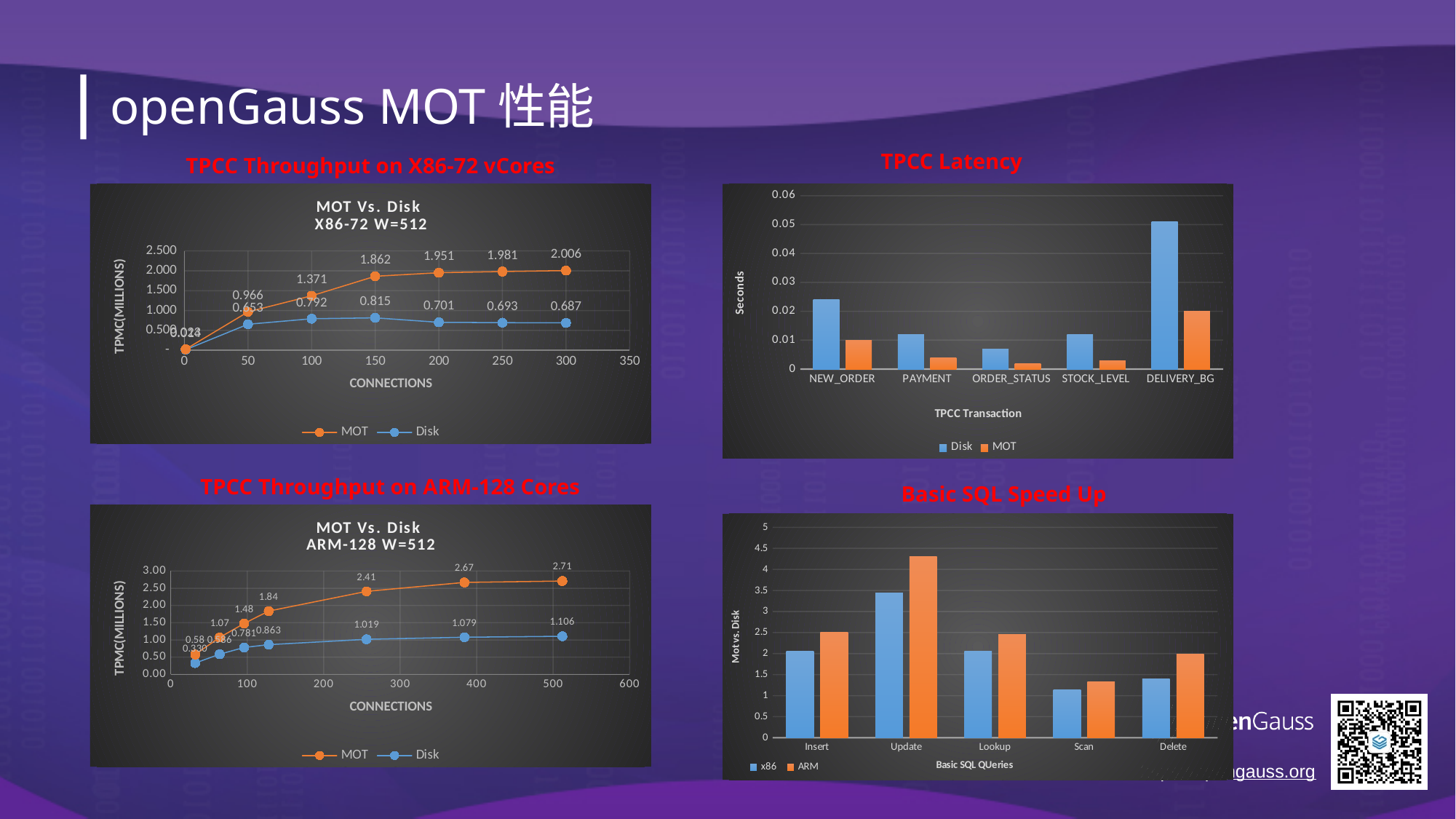
In the TPCC Latency chart, which TPCC transaction has the highest Disk latency? DELIVERY_BG In the MOT Vs. Disk ARM-128 W=512 chart, how many series does the legend list? 2 In the MOT Vs. Disk X86-72 W=512 chart, what is the difference between the MOT and Disk values at 200 connections? 1.250 In the Basic SQL Speed Up chart, is the ARM value for Update greater or less than 4? greater What kind of chart is the Basic SQL Speed Up chart? bar chart In the MOT Vs. Disk X86-72 W=512 chart, what is the MOT value at 300 connections? 2.006 In the MOT Vs. Disk X86-72 W=512 chart, does the Disk series rise or fall between 150 and 300 connections? fall In the MOT Vs. Disk ARM-128 W=512 chart, what is the lowest Disk value shown? 0.330 In the TPCC Latency chart, how many TPCC transaction categories are shown? 5 In the TPCC Latency chart, is the Disk value for DELIVERY_BG greater or less than 0.04? greater In the MOT Vs. Disk X86-72 W=512 chart, what is the Disk value at 150 connections? 0.815 In the MOT Vs. Disk ARM-128 W=512 chart, what is the highest MOT value shown? 2.71